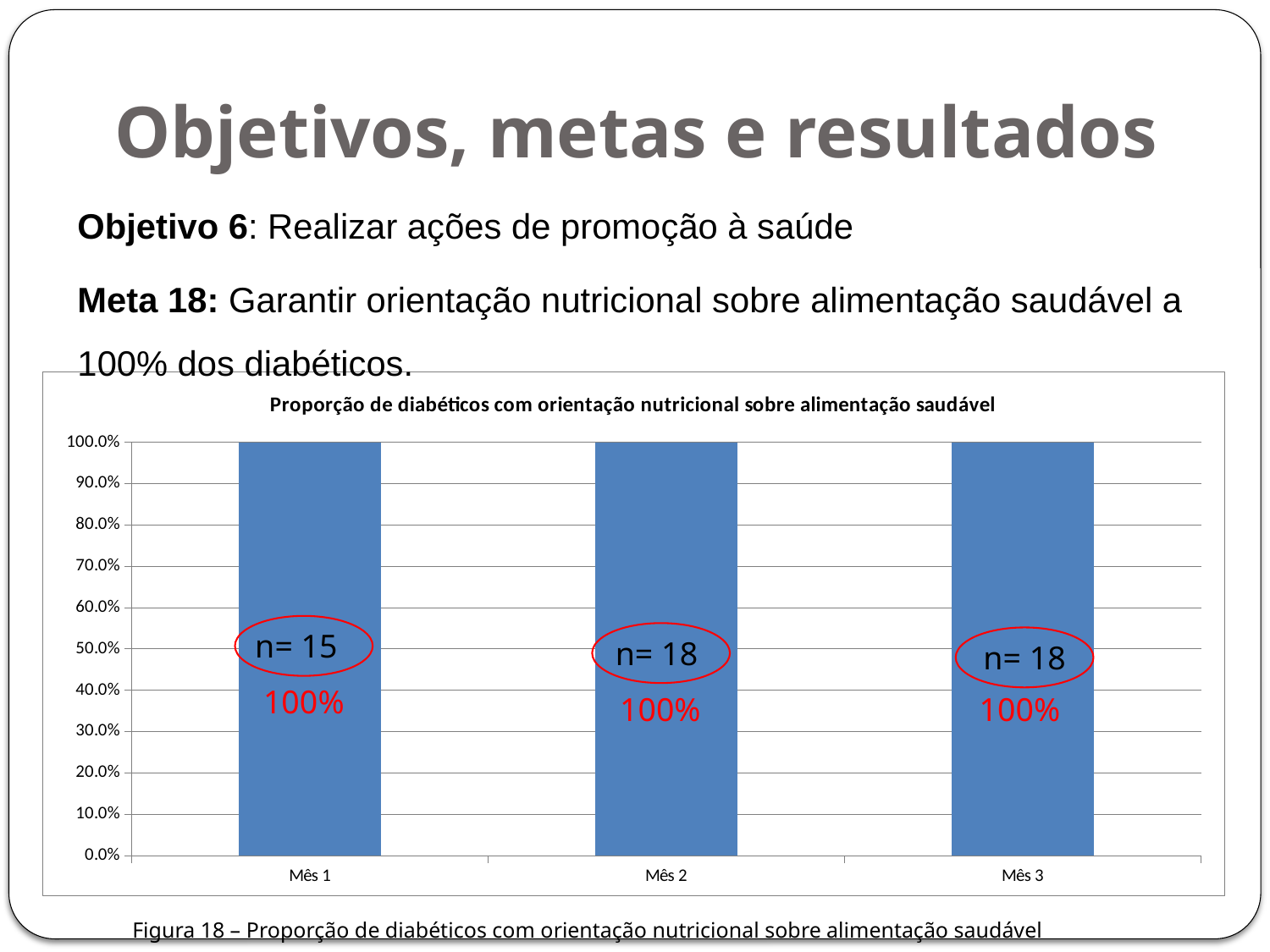
What is the title of the chart? Proporção de diabéticos com orientação nutricional sobre alimentação saudável What is the n value annotated on the bar for Mês 1? n= 15 Do the values rise, fall, or stay the same from Mês 1 to Mês 3? stay the same What is the highest value shown on the y axis of the chart? 100.0% What kind of chart is shown on the slide? bar chart What is the difference between the values for Mês 1 and Mês 3? 0% What is the value for Mês 3 in the chart? 100% Is the value for Mês 2 greater or less than 90.0%? greater Is the value for Mês 3 greater or less than 50.0%? greater What is the value for Mês 2 in the chart? 100% What is the value for Mês 1 in the chart? 100% How many categories (months) are shown on the x axis of the chart? 3